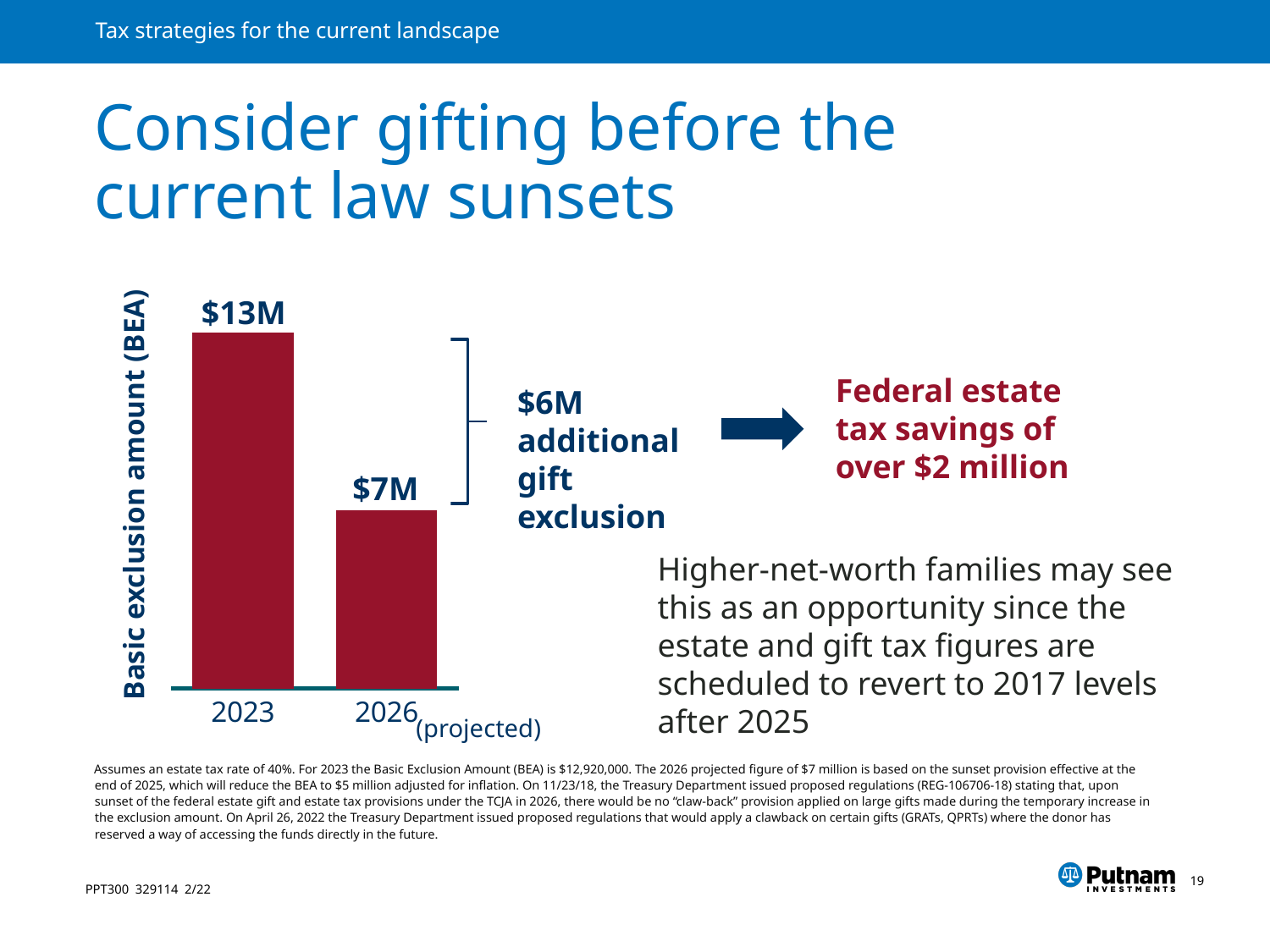
Which year has the higher basic exclusion amount, 2023 or 2026? 2023 Which year has the lowest basic exclusion amount in the chart? 2026 What is the difference between the 2023 and 2026 basic exclusion amounts? $6M How many bars are plotted in the chart? 2 What is the projected basic exclusion amount shown for 2026? $7M What kind of chart is shown on the slide? Bar chart What does the bracket between the two bars label the $6M gap as? $6M additional gift exclusion What is the label on the vertical axis of the chart? Basic exclusion amount (BEA) Do the values rise or fall from 2023 to 2026? Fall What is the basic exclusion amount shown for 2023? $13M